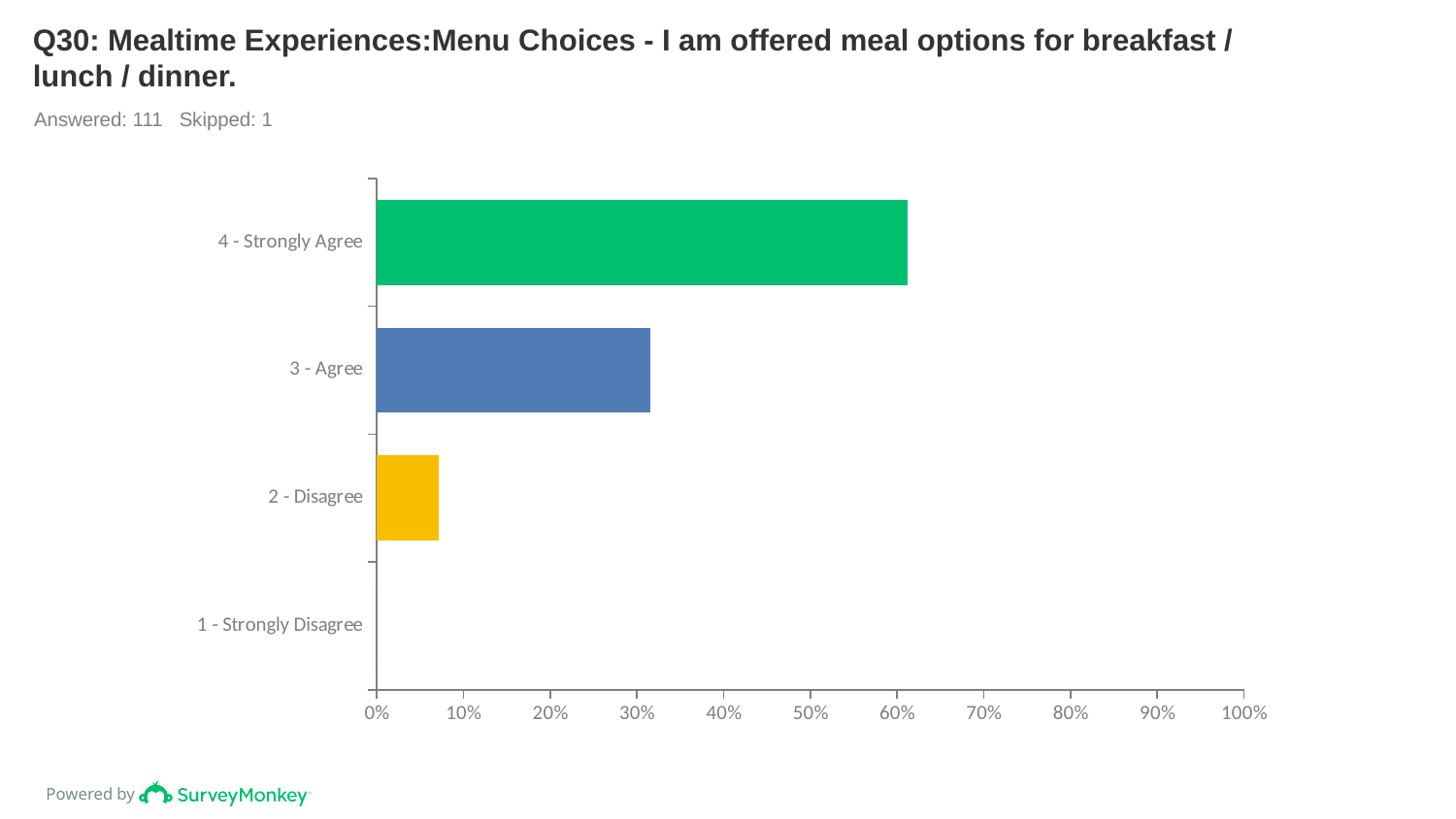
Is the value for 4 - Strongly Agree greater or less than 50%? greater Which response category has the lowest value? 1 - Strongly Disagree Which response category has the highest value? 4 - Strongly Agree Is the value for 3 - Agree greater or less than 40%? less Is the value for 4 - Strongly Agree greater or less than 70%? less Which is larger, the value for 4 - Strongly Agree or the value for 3 - Agree? 4 - Strongly Agree How many respondents skipped this question according to the slide? 1 What kind of chart is shown on the slide? bar chart How many response categories are shown on the chart? 4 Which is larger, the value for 3 - Agree or the value for 2 - Disagree? 3 - Agree How many respondents answered this question according to the slide? 111